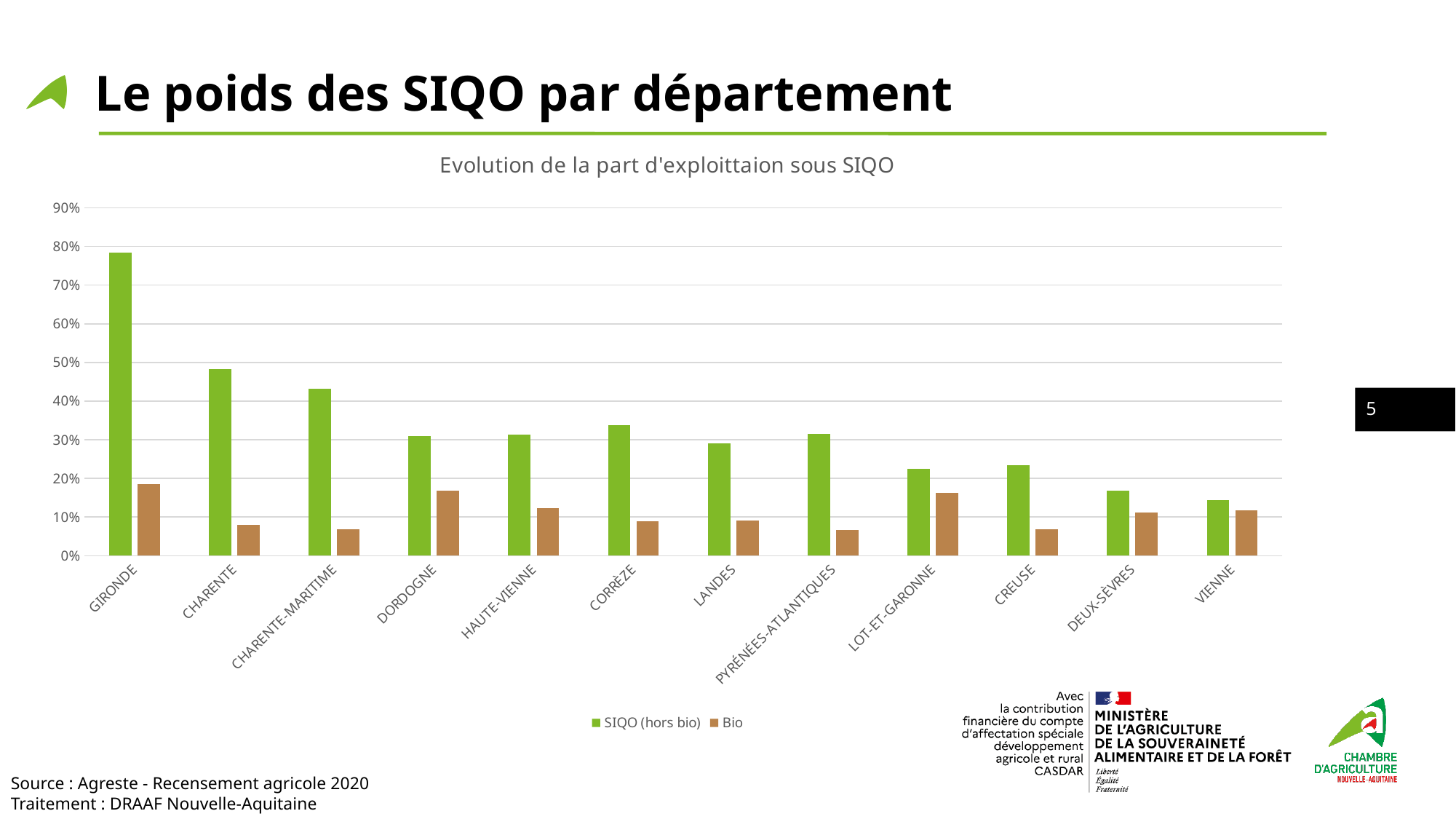
Is the Bio value for Gironde greater or less than 20%? less Which is larger, the SIQO (hors bio) value for Charente or for Charente-Maritime? Charente What kind of chart is shown on the slide? bar chart Is the SIQO (hors bio) value for Charente greater or less than 50%? less Which is larger, the Bio value for Dordogne or for Charente? Dordogne How many departments are shown on the x axis of the chart? 12 Which department has the lowest SIQO (hors bio) value? Vienne How many series does the chart legend list? 2 Is the SIQO (hors bio) value for Gironde greater or less than 70%? greater Which department has the highest SIQO (hors bio) value? Gironde What is the title of the chart? Evolution de la part d'exploittaion sous SIQO